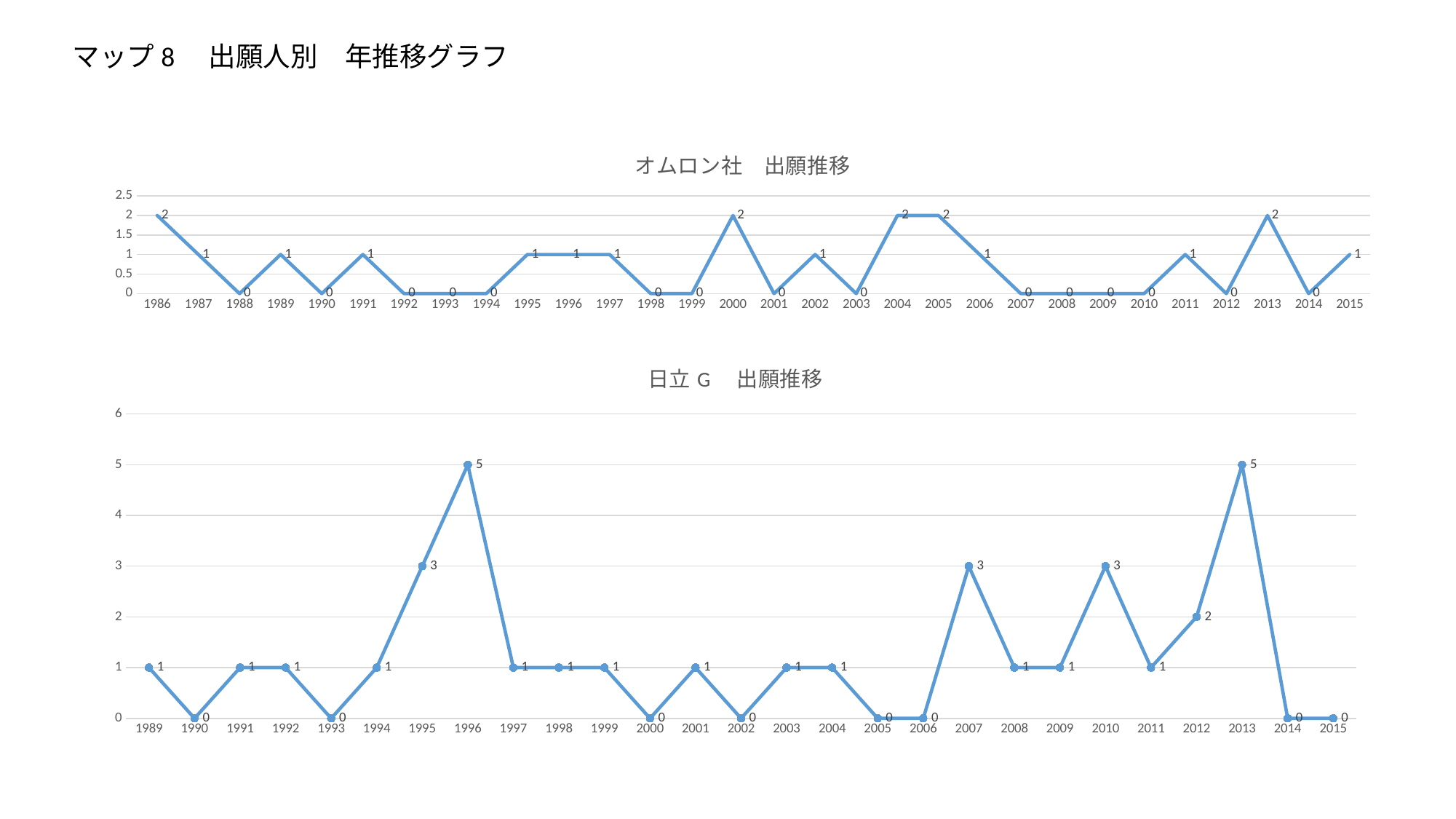
In the 日立G 出願推移 chart, what is the difference between the values for 1996 and 1997? 4 In the オムロン社 出願推移 chart, what is the value for 2006? 1 How many years are plotted on the x axis of the オムロン社 出願推移 chart? 30 How many years are plotted on the x axis of the 日立G 出願推移 chart? 27 What type of chart is the 日立G 出願推移 chart? Line chart In the 日立G 出願推移 chart, which year has the larger value, 2007 or 2008? 2007 In the オムロン社 出願推移 chart, which year has the larger value, 2000 or 2001? 2000 In the オムロン社 出願推移 chart, what is the value for 1986? 2 In the 日立G 出願推移 chart, what is the value for 2012? 2 In the 日立G 出願推移 chart, do the values rise or fall from 2013 to 2014? Fall In the 日立G 出願推移 chart, what is the value for 1995? 3 In the 日立G 出願推移 chart, what is the highest value plotted? 5